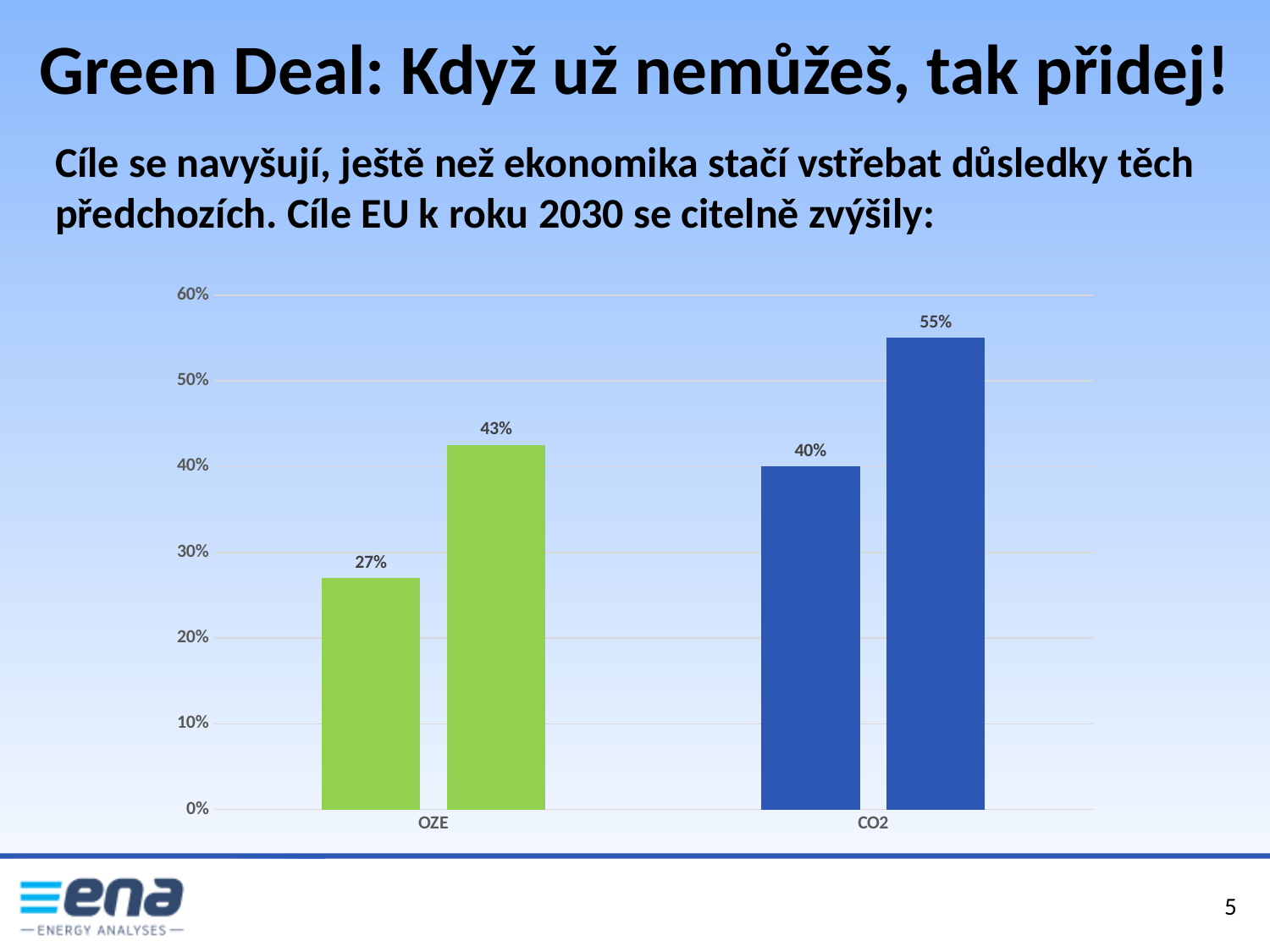
Which bar in the chart has the highest value? The right bar for CO2 (55%) What kind of chart is shown on the slide? Bar chart Which is larger: the right bar for OZE or the left bar for CO2? The right bar for OZE (43%) What is the difference between the two CO2 bars? 15 percentage points What is the value of the left (first) bar for CO2? 40% What is the difference between the two OZE bars? 16 percentage points What is the value of the left (first) bar for OZE? 27% What is the value of the right (second) bar for CO2? 55% Which bar in the chart has the lowest value? The left bar for OZE (27%) What colour are the bars for the CO2 category? Blue How many categories are shown on the x axis? 2 What is the value of the right (second) bar for OZE? 43%